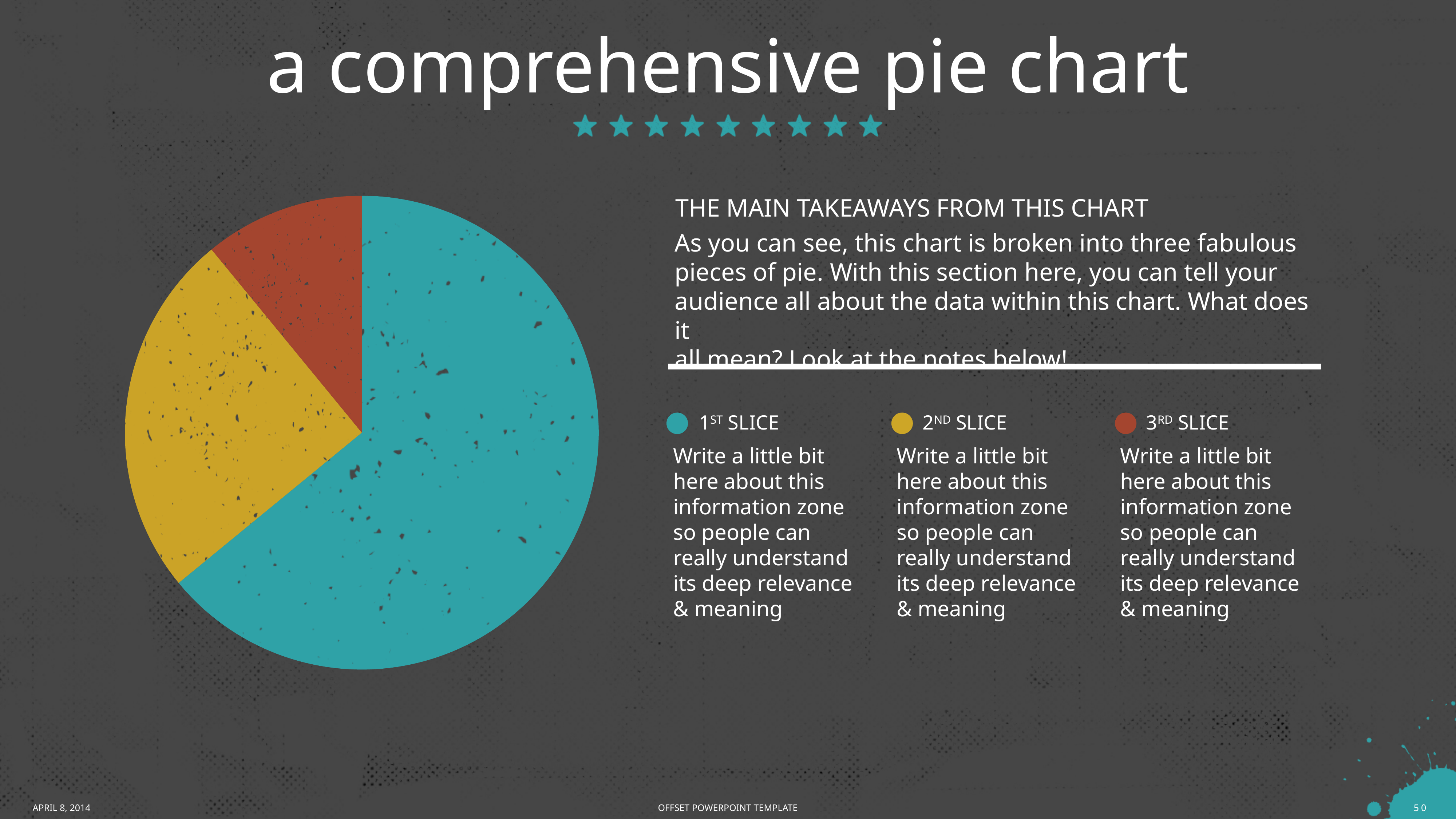
Which is larger in the pie chart, the 2nd Slice or the 3rd Slice? 2nd Slice What colour is the 3rd Slice in the pie chart? red Which is larger in the pie chart, the 1st Slice or the 2nd Slice? 1st Slice Does the 1st Slice take up more or less than half of the pie chart? more What colour is the 1st Slice in the pie chart? teal How many slices does the pie chart have? 3 What kind of chart is shown on the slide? pie chart Which slice of the pie chart is the smallest? 3rd Slice Which slice of the pie chart is the largest? 1st Slice